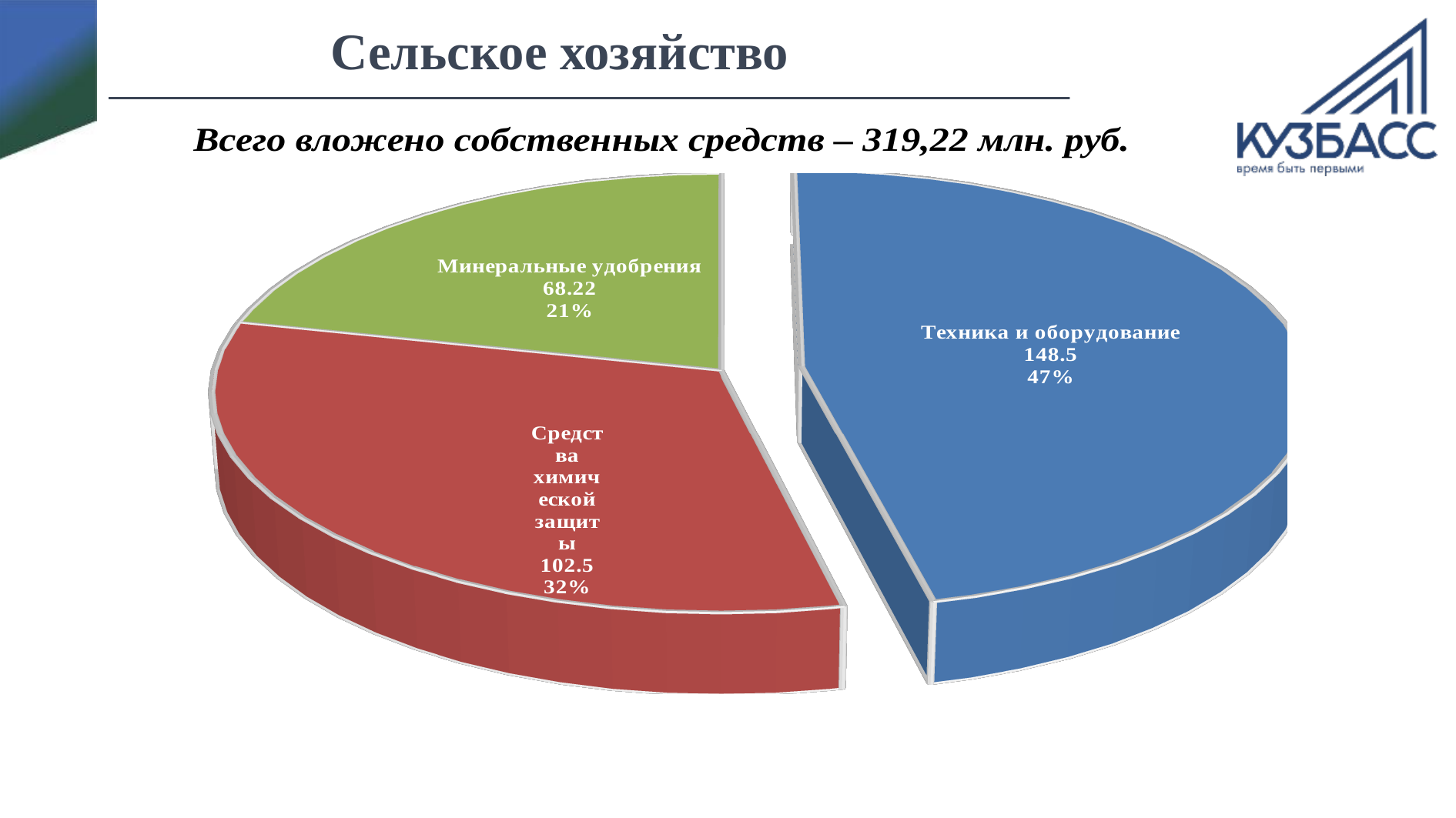
How many slices does the pie chart have? 3 What share of the pie does Минеральные удобрения take? 21% What is the value for Средства химической защиты? 102.5 What share of the pie does Техника и оборудование take? 47% What share of the pie does Средства химической защиты take? 32% What is the difference between the values for Техника и оборудование and Средства химической защиты? 46 Which category has the smallest slice? Минеральные удобрения What is the value for Техника и оборудование? 148.5 Which colour is the slice for Техника и оборудование? Blue What kind of chart is shown on the slide? Pie chart What is the value for Минеральные удобрения? 68.22 Which category has the largest slice? Техника и оборудование